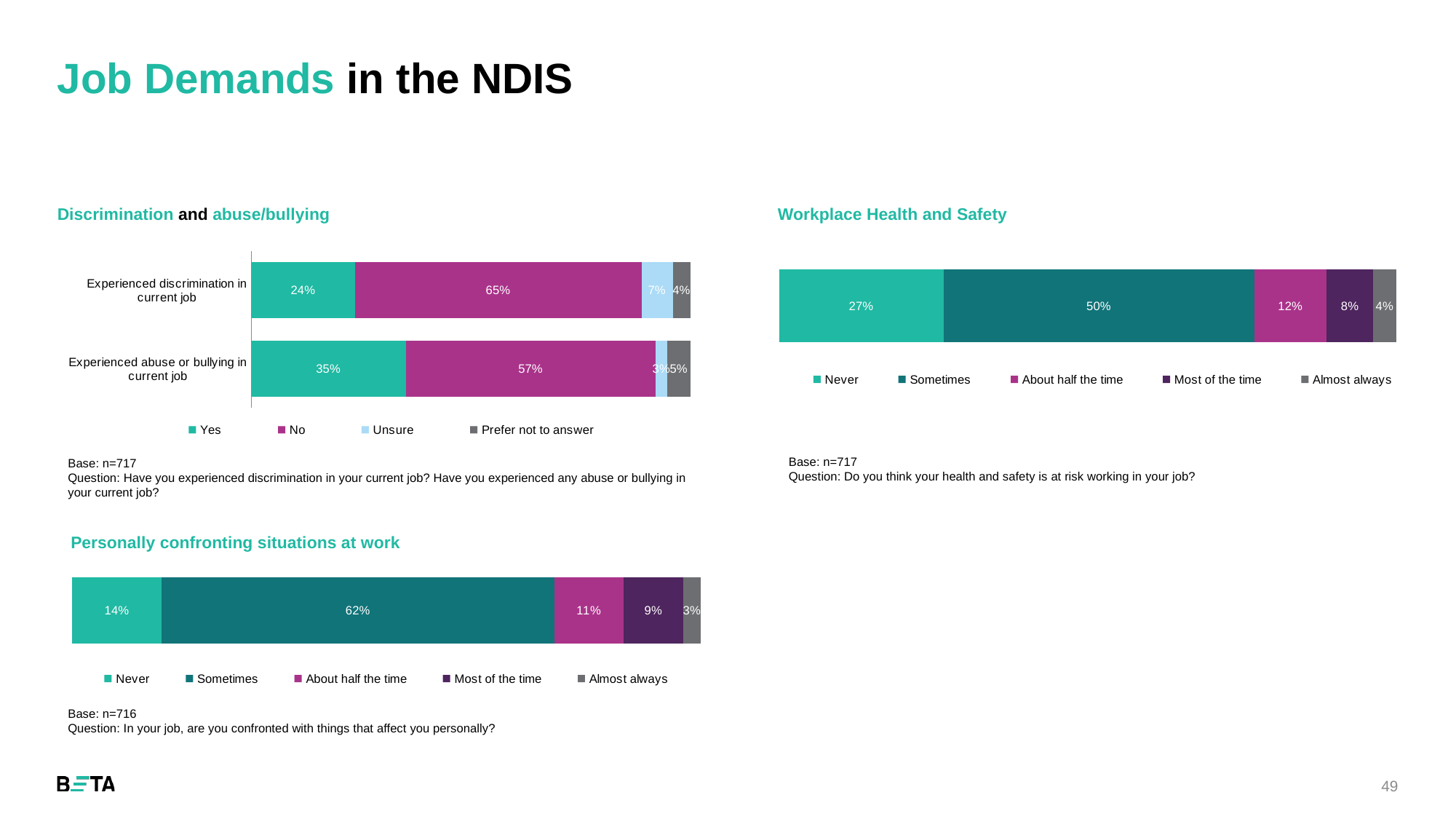
In the 'Discrimination and abuse/bullying' chart, what percentage answered Yes to experiencing discrimination in their current job? 24% In the 'Personally confronting situations at work' chart, which response has the highest percentage? Sometimes In the 'Workplace Health and Safety' chart, what is the difference between the Never and About half the time percentages? 15% In the 'Discrimination and abuse/bullying' chart, what is the difference between the Yes percentages for abuse or bullying and for discrimination? 11% What type of chart is the 'Workplace Health and Safety' chart? Stacked bar chart In the 'Discrimination and abuse/bullying' chart, which category has the larger Yes percentage? Experienced abuse or bullying in current job In the 'Personally confronting situations at work' chart, what percentage answered Never? 14% In the 'Discrimination and abuse/bullying' chart, what percentage answered No to experiencing abuse or bullying in their current job? 57% In the 'Personally confronting situations at work' chart, how many series does the legend list? 5 In the 'Workplace Health and Safety' chart, what percentage answered Sometimes? 50% In the 'Workplace Health and Safety' chart, which response has the lowest percentage? Almost always In the 'Discrimination and abuse/bullying' chart, how many series does the legend list? 4